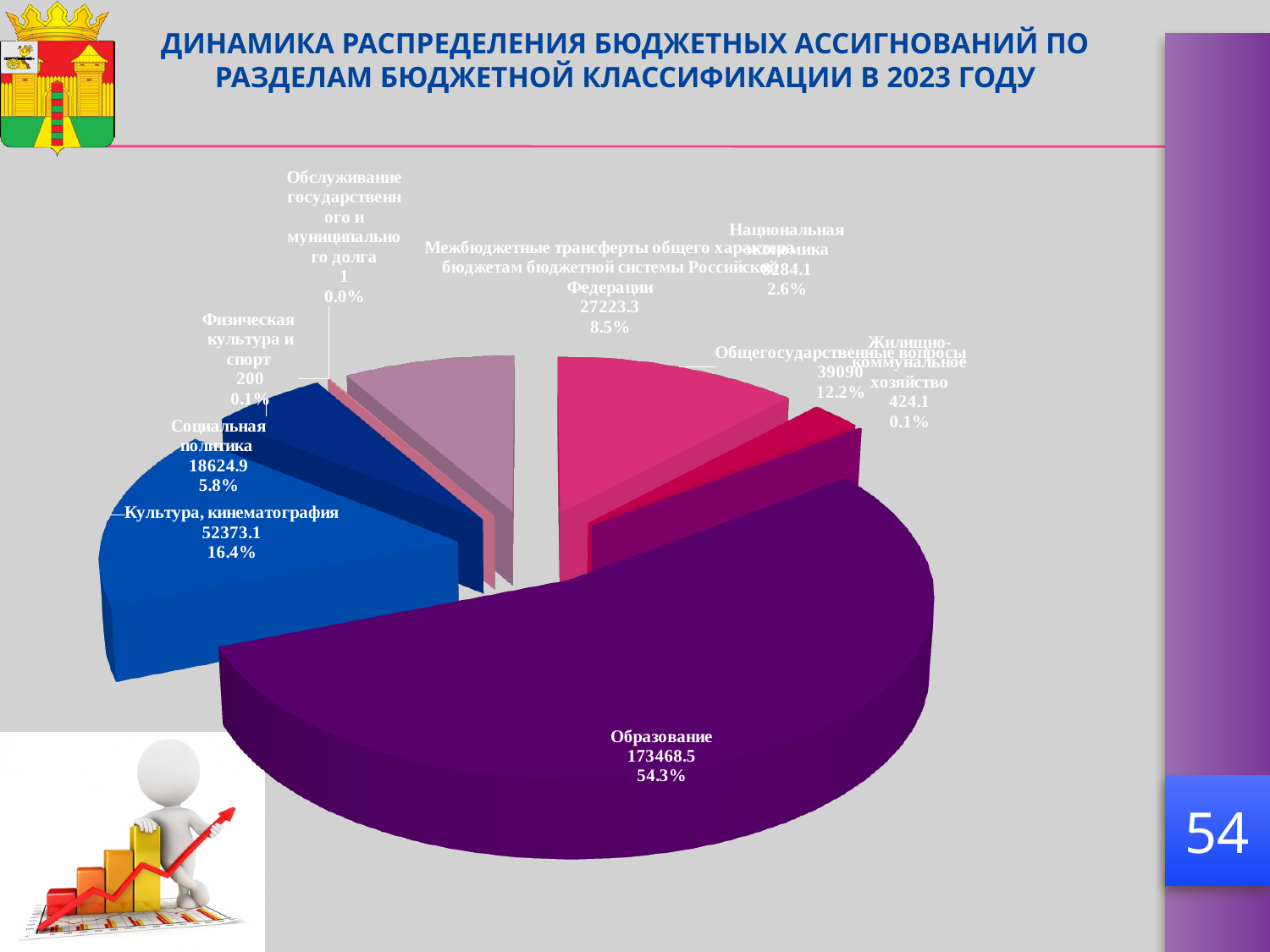
What is the difference between the values for Культура, кинематография and Социальная политика? 33748.2 Which category has the smallest value in the pie chart? Обслуживание государственного и муниципального долга What share of the pie does Образование represent? 54.3% What is the value shown for Общегосударственные вопросы? 39090 Which category has the largest slice of the pie? Образование What kind of chart is shown on the slide? pie chart Which is larger: Общегосударственные вопросы or Социальная политика? Общегосударственные вопросы What share of the pie does Межбюджетные трансферты общего характера бюджетам бюджетной системы Российской Федерации represent? 8.5% What is the value shown for Культура, кинематография? 52373.1 What share of the pie does Культура, кинематография represent? 16.4% What is the value shown for Образование? 173468.5 How many categories are shown in the pie chart? 9